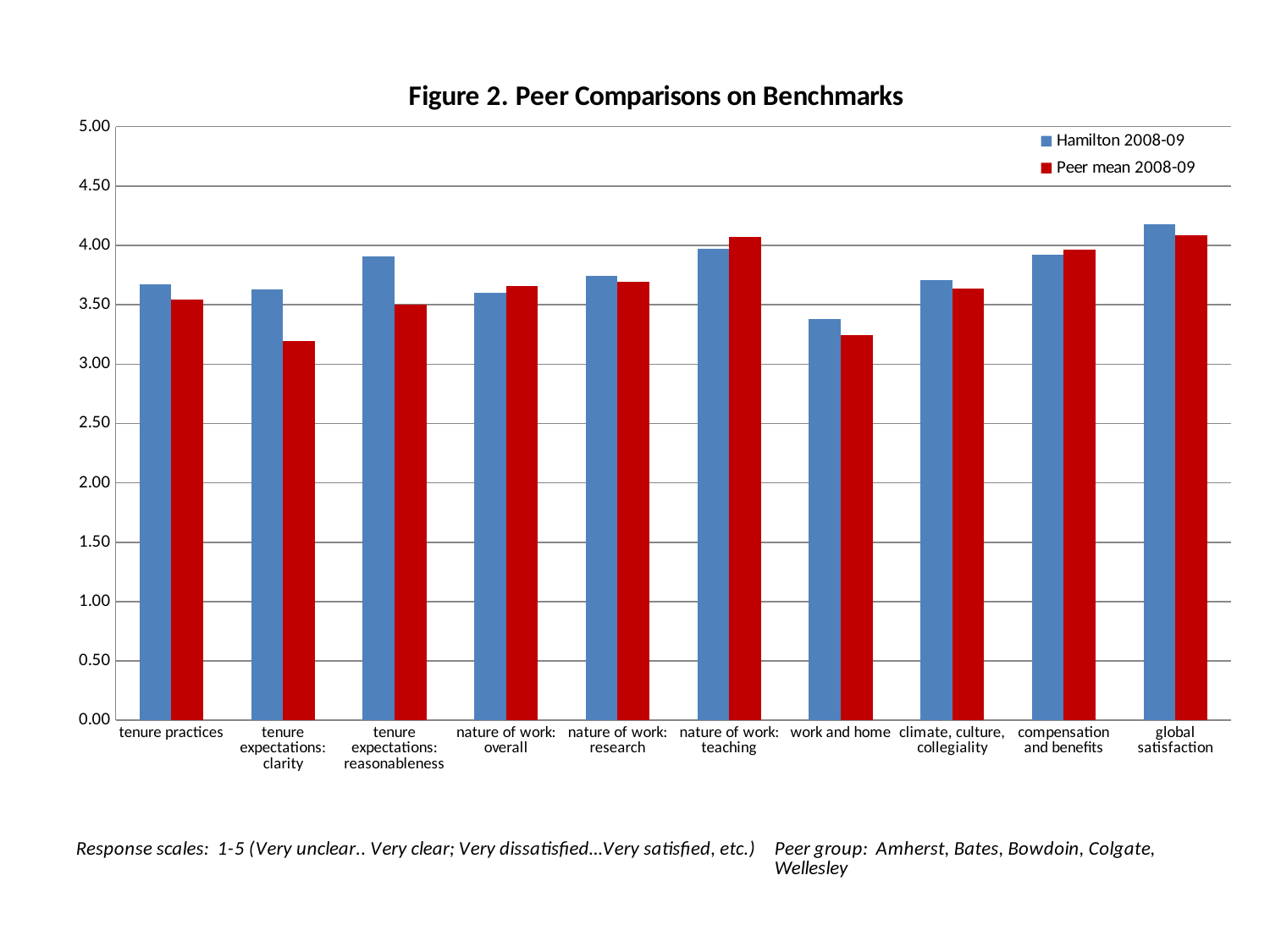
What type of chart is shown in Figure 2. Peer Comparisons on Benchmarks? bar chart For tenure expectations: reasonableness, which is larger, Hamilton 2008-09 or Peer mean 2008-09? Hamilton 2008-09 Is the Hamilton 2008-09 value for work and home greater or less than 3.50? less Is the Peer mean 2008-09 value for tenure expectations: clarity greater or less than 3.50? less Which category has the lowest Hamilton 2008-09 value? work and home How many series does the legend list? 2 For nature of work: teaching, which is larger, Hamilton 2008-09 or Peer mean 2008-09? Peer mean 2008-09 Which category has the highest Hamilton 2008-09 value? global satisfaction How many benchmark categories are shown on the x axis? 10 Is the Hamilton 2008-09 value for global satisfaction greater or less than 4.00? greater What colour are the Peer mean 2008-09 bars? red For tenure expectations: clarity, which is larger, Hamilton 2008-09 or Peer mean 2008-09? Hamilton 2008-09